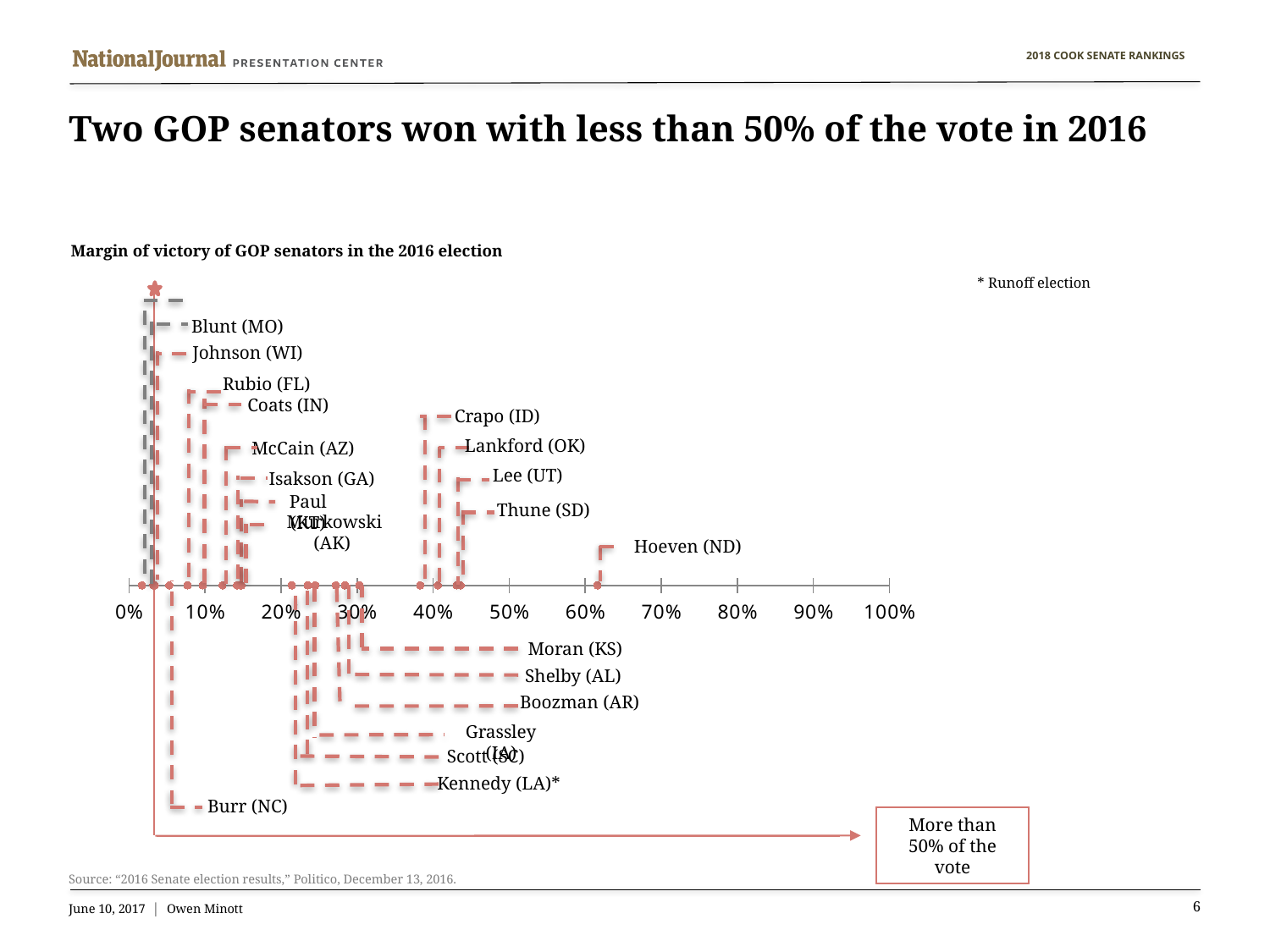
What is the title of the chart? Margin of victory of GOP senators in the 2016 election Which senator has the highest margin of victory on the chart? Hoeven (ND) Is the margin of victory for Burr (NC) greater or less than 10%? less Which has the larger margin of victory, Rubio (FL) or Moran (KS)? Moran (KS) Is the margin of victory for Hoeven (ND) greater or less than 50%? greater Is the margin of victory for Moran (KS) greater or less than 40%? less What kind of chart is shown on the slide? Dot plot (scatter chart along a single axis) Which has the larger margin of victory, Hoeven (ND) or Thune (SD)? Hoeven (ND) Which senator's label is marked with an asterisk indicating a runoff election? Kennedy (LA)